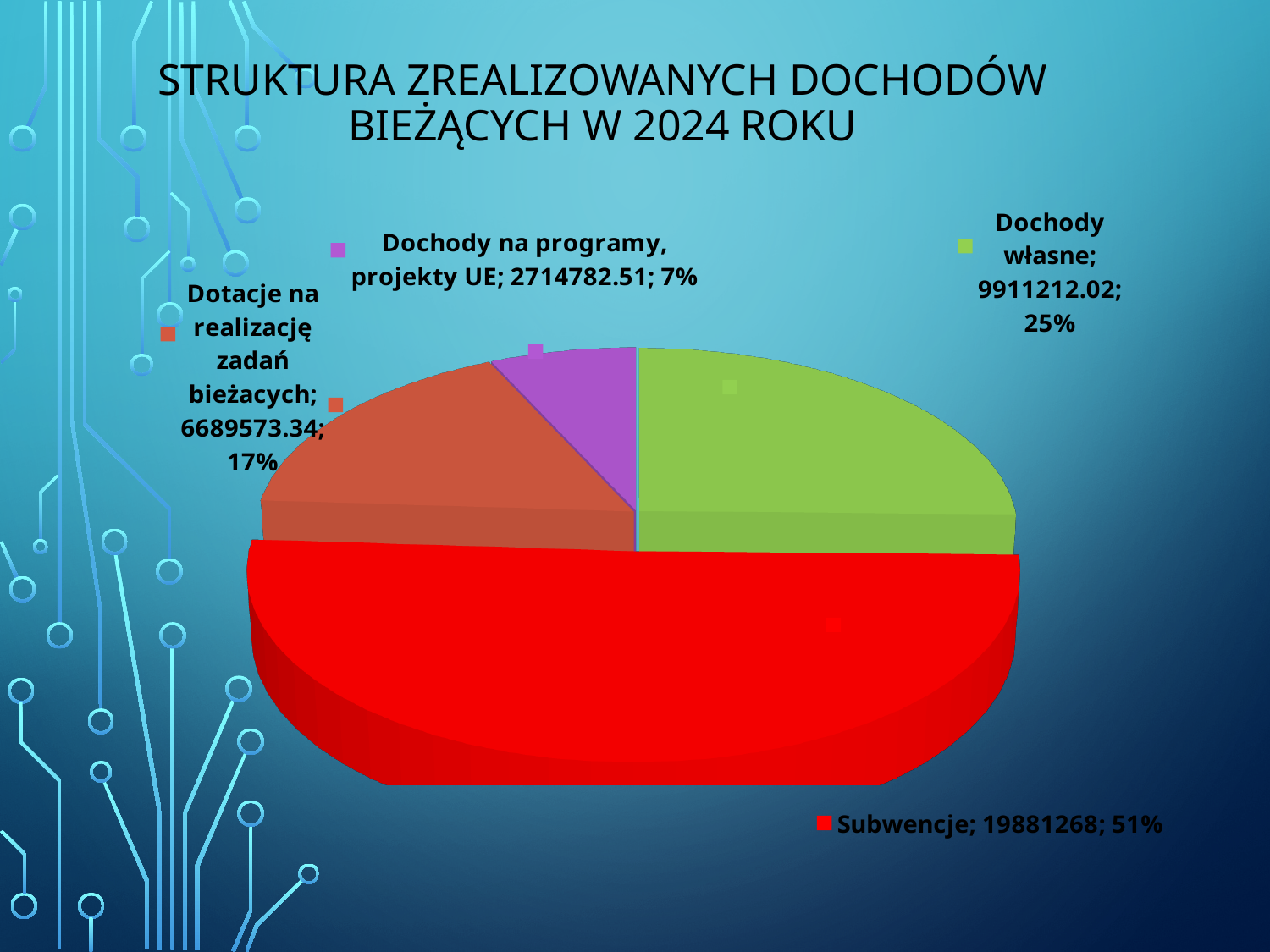
What is the value for Dochody własne? 9911212.02 Which category has the largest slice? Subwencje How many slices does the pie chart have? 4 What is the value for Dotacje na realizację zadań bieżacych? 6689573.34 Which category has the smallest slice? Dochody na programy, projekty UE What kind of chart is shown on the slide? pie chart Which is larger, Dochody własne or Dotacje na realizację zadań bieżacych? Dochody własne What is the value for Dochody na programy, projekty UE? 2714782.51 What share of the pie does Dochody własne represent? 25% What is the value for Subwencje? 19881268 What share of the pie does Subwencje represent? 51% What share of the pie does Dotacje na realizację zadań bieżacych represent? 17%